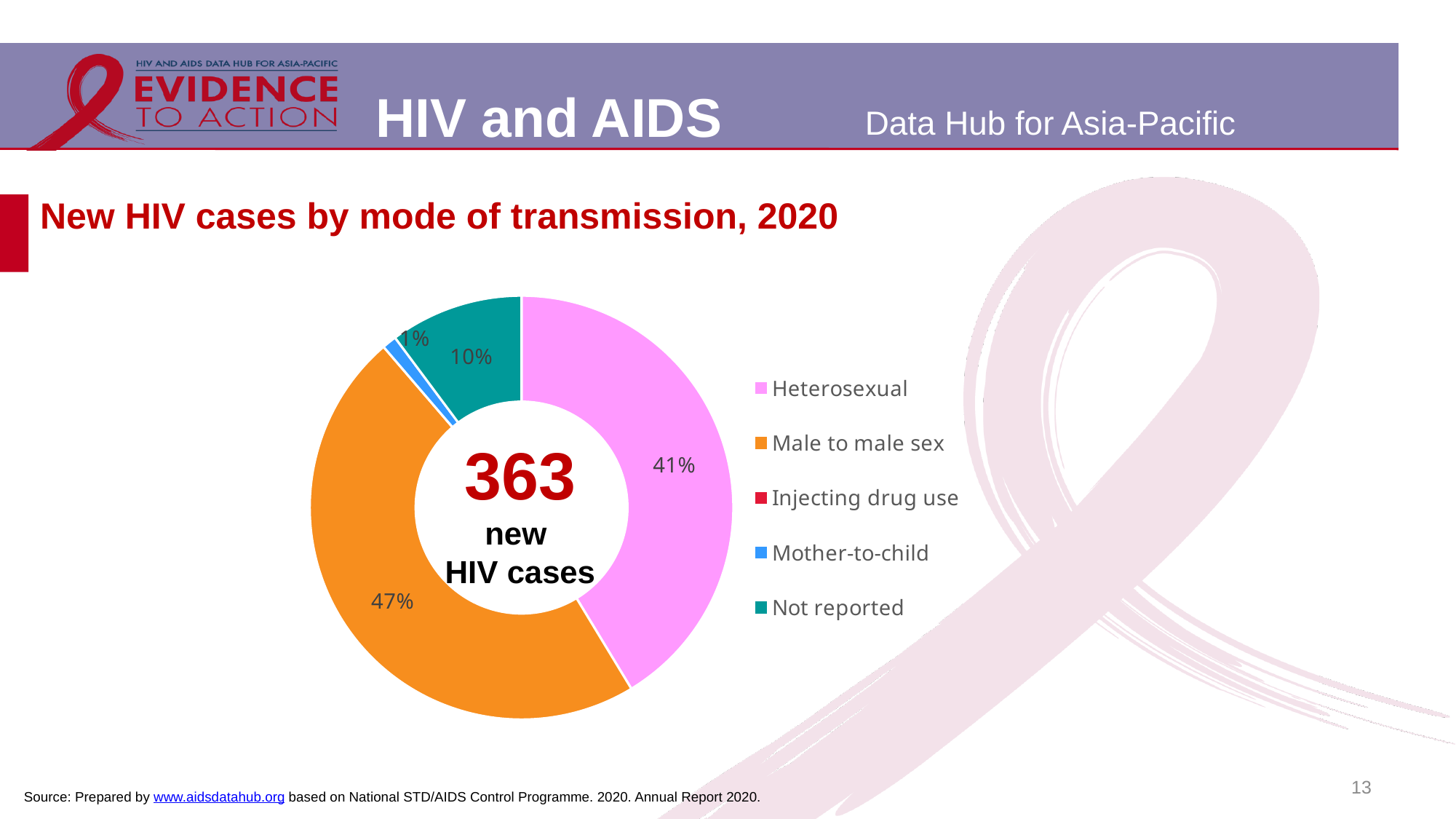
What share of new HIV cases is attributed to Heterosexual transmission? 41% What percentage of new HIV cases is labelled as Not reported? 10% How many modes of transmission are listed in the legend? 5 Which mode of transmission accounts for the largest share of new HIV cases? Male to male sex Which colour represents Not reported in the chart? Teal (green) Which is larger, the share for Heterosexual or the share for Not reported? Heterosexual What is the total number of new HIV cases shown in the centre of the chart? 363 What type of chart is used to show new HIV cases by mode of transmission? Pie (donut) chart What is the title of the chart? New HIV cases by mode of transmission, 2020 What is the difference in percentage points between the Male to male sex share and the Heterosexual share? 6 percentage points What share of new HIV cases is attributed to Male to male sex? 47% What share of new HIV cases is attributed to Mother-to-child transmission? 1%